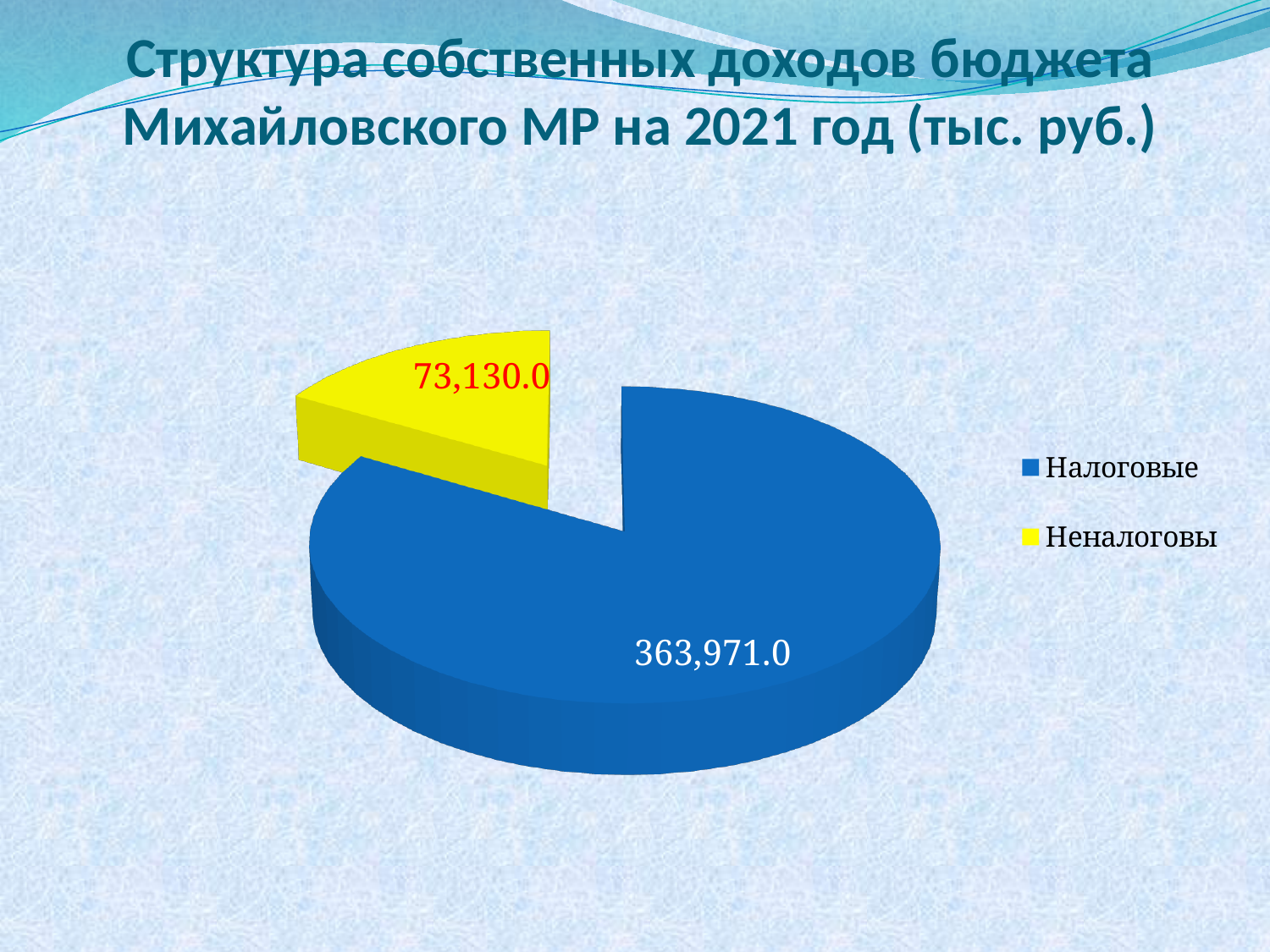
What colour is the Налоговые slice in the pie chart? Blue Which category has the smallest slice in the pie chart? Неналоговы What kind of chart is shown on the slide? Pie chart What value is shown for the Налоговые slice of the pie chart? 363,971.0 What share of the total does the Налоговые slice represent, to one decimal place? 83.3% What is the total of the two values shown in the pie chart? 437,101.0 Which category has the largest slice in the pie chart? Налоговые What value is shown for the yellow (Неналоговы) slice of the pie chart? 73,130.0 How many entries does the legend list? 2 What is the difference between the Налоговые value and the Неналоговы value? 290,841.0 How many slices does the pie chart have? 2 Which is larger, the Налоговые slice or the Неналоговы slice? Налоговые